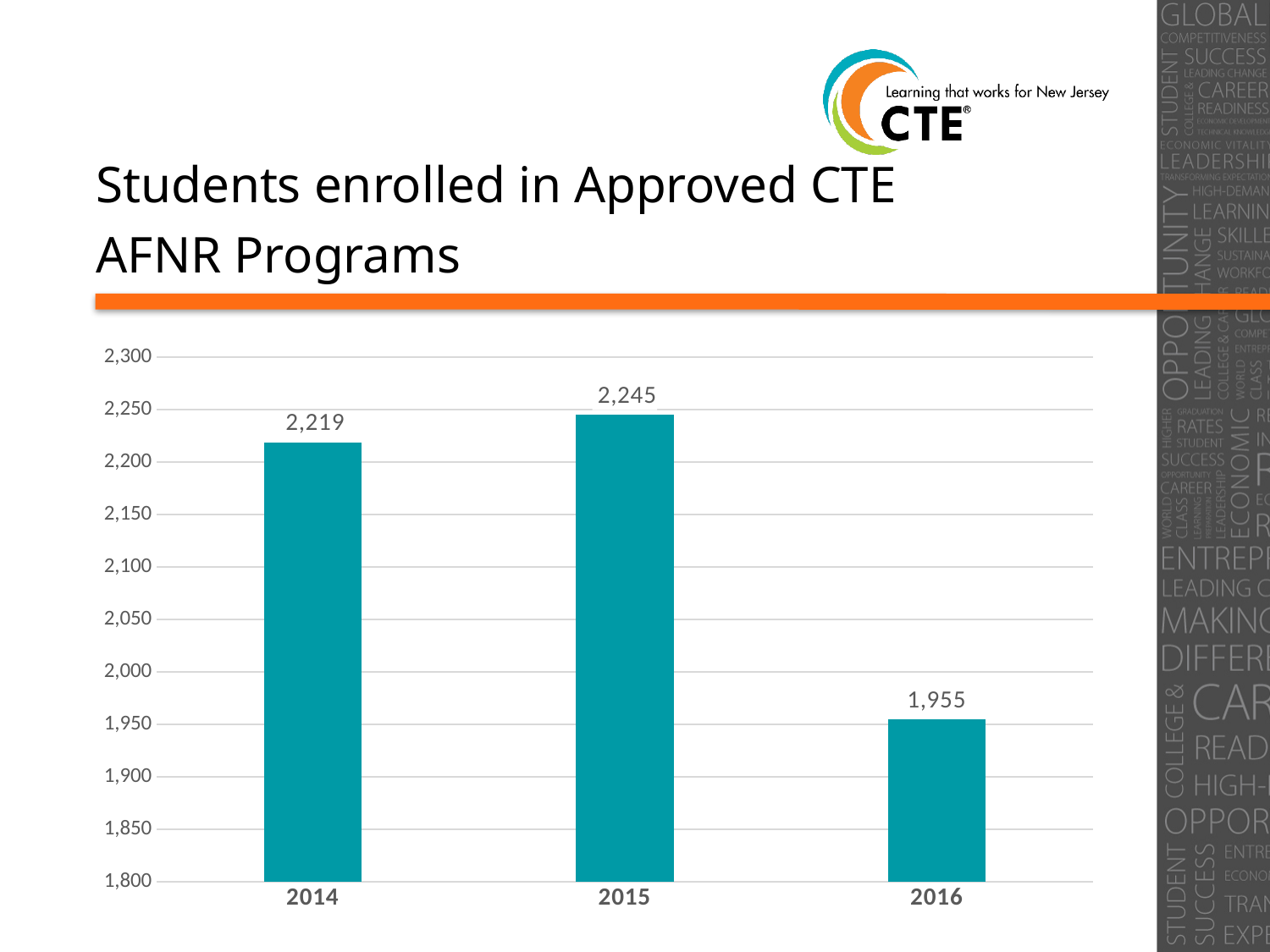
What kind of chart is shown on the slide? bar chart Is the value for 2016 greater or less than 2,000? less What is the value shown for 2016? 1,955 Which year has the larger value, 2014 or 2016? 2014 How many students were enrolled in approved CTE AFNR programs in 2014? 2,219 What is the difference between the 2015 and 2016 values? 290 Which year has the lowest enrollment? 2016 What is the value shown for 2015? 2,245 Does enrollment rise or fall from 2015 to 2016? fall How many years are shown on the x axis? 3 What is the difference between the 2015 and 2014 values? 26 Which year has the highest enrollment? 2015